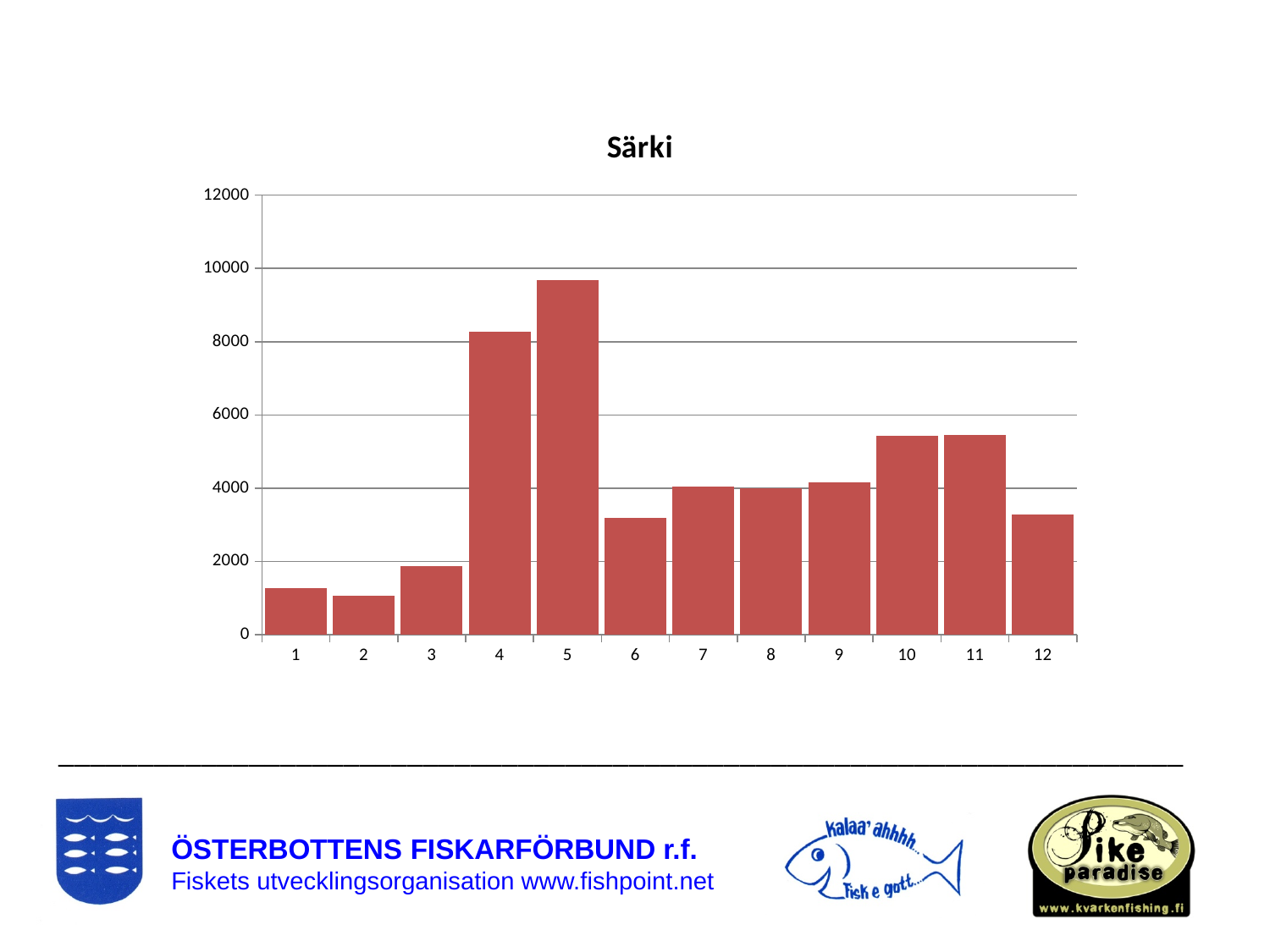
How many categories are shown on the x axis of the chart? 12 Which category has the highest value in the chart? 5 Which category has the lowest value in the chart? 2 Is the value for category 5 greater or less than 8000? greater Is the value for category 6 greater or less than 4000? less Which has the larger value, category 4 or category 5? 5 Is the value for category 10 greater or less than 6000? less Which has the larger value, category 3 or category 6? 6 Do the values rise or fall from category 1 to category 5? rise What kind of chart is shown on the slide? bar chart What is the title of the chart? Särki